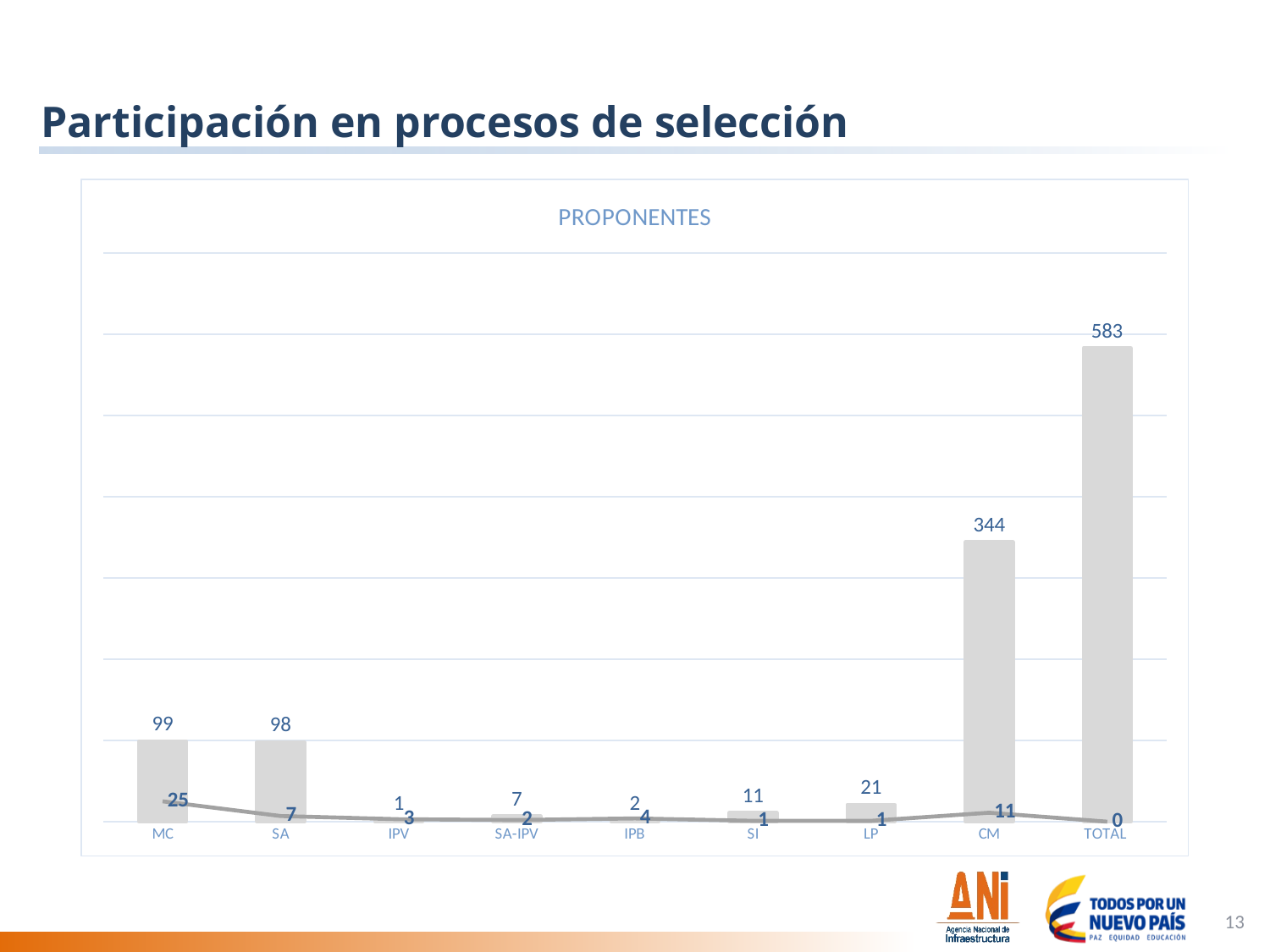
What is the bar value for TOTAL in the PROPONENTES chart? 583 What is the title of the chart on the slide? PROPONENTES What is the bar value for LP in the PROPONENTES chart? 21 Which has a larger bar value in the PROPONENTES chart, LP or SI? LP What is the value of the line series at TOTAL in the PROPONENTES chart? 0 What is the value of the line series at MC in the PROPONENTES chart? 25 Excluding TOTAL, which category has the highest bar in the PROPONENTES chart? CM What is the difference between the bar values for MC and SA in the PROPONENTES chart? 1 Which category has the lowest bar in the PROPONENTES chart? IPV How many categories are shown on the x axis of the PROPONENTES chart? 9 What is the bar value for CM in the PROPONENTES chart? 344 What is the difference between the bar values for CM and SI in the PROPONENTES chart? 333